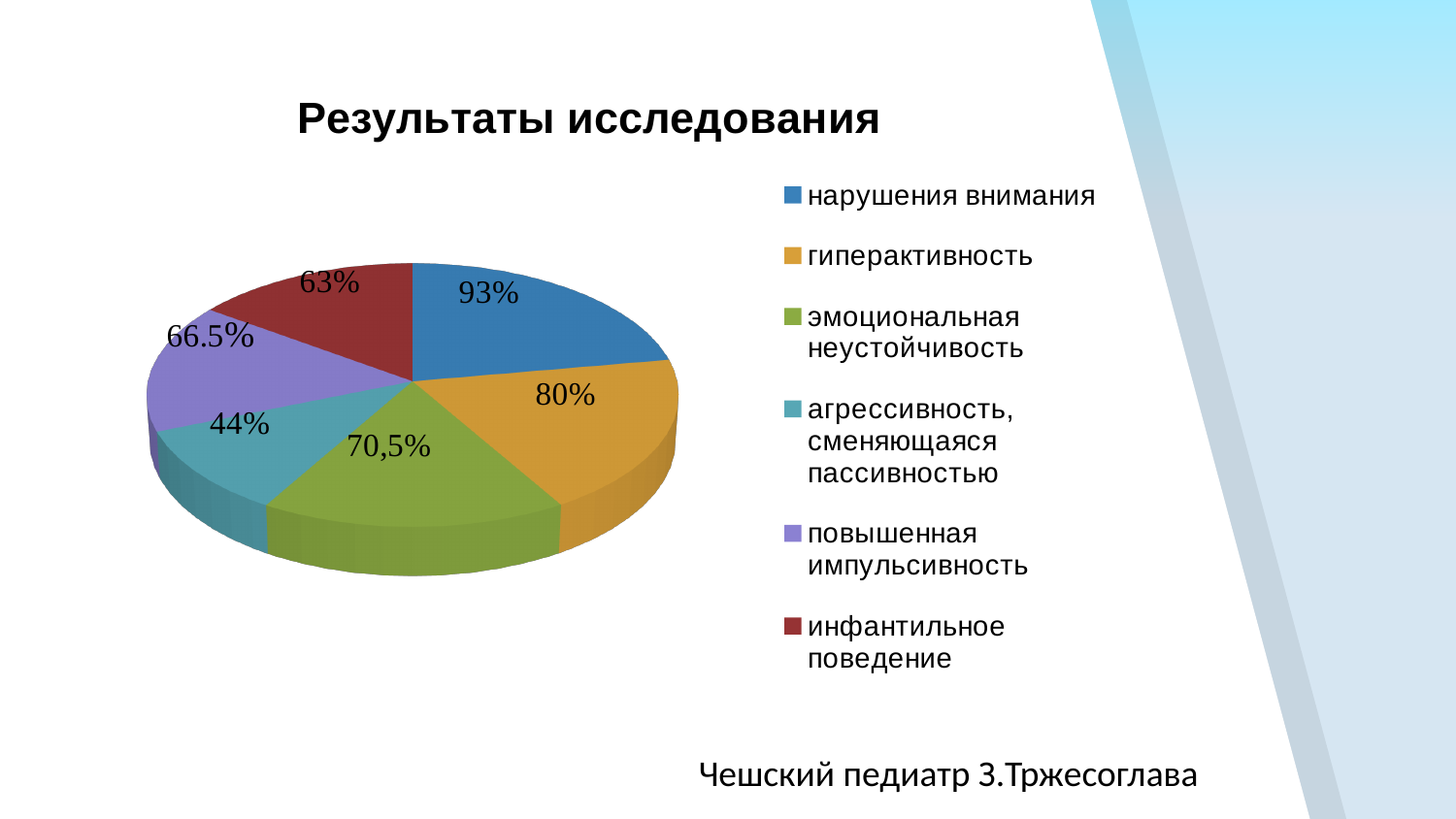
What value is shown for эмоциональная неустойчивость? 70,5% What is the difference between the values for нарушения внимания and гиперактивность? 13% What type of chart is shown on the slide? pie chart Which category has the lowest value? агрессивность, сменяющаяся пассивностью What value is shown for гиперактивность? 80% What value is shown for агрессивность, сменяющаяся пассивностью? 44% What value is shown for инфантильное поведение? 63% Which is larger, the value for повышенная импульсивность or the value for инфантильное поведение? повышенная импульсивность What value is shown for нарушения внимания? 93% Which category has the highest value? нарушения внимания What is the title of the chart? Результаты исследования How many categories does the legend list? 6